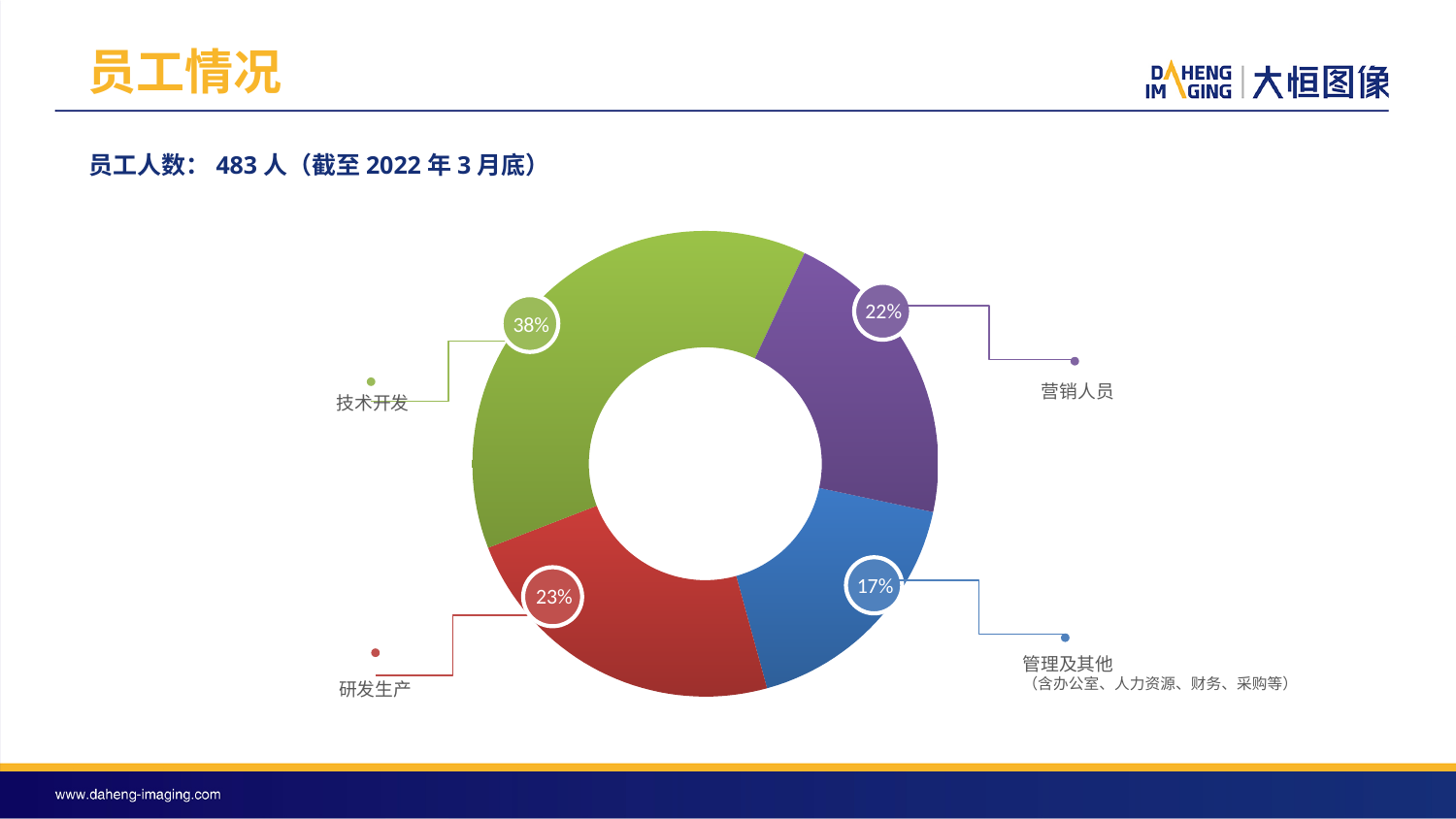
Which category has the largest share of employees? 技术开发 What is the difference in percentage points between 技术开发 and 管理及其他? 21 What kind of chart is shown on the slide? Pie chart (donut) What is the difference in percentage points between 研发生产 and 营销人员? 1 Which category has the smallest share of employees? 管理及其他 Which has a larger share, 技术开发 or 营销人员? 技术开发 What percentage of employees are in 技术开发? 38% What colour is the 研发生产 slice? Red What percentage of employees are in 研发生产? 23% How many categories does the chart show? 4 What percentage of employees are in 管理及其他? 17% What percentage of employees are 营销人员? 22%